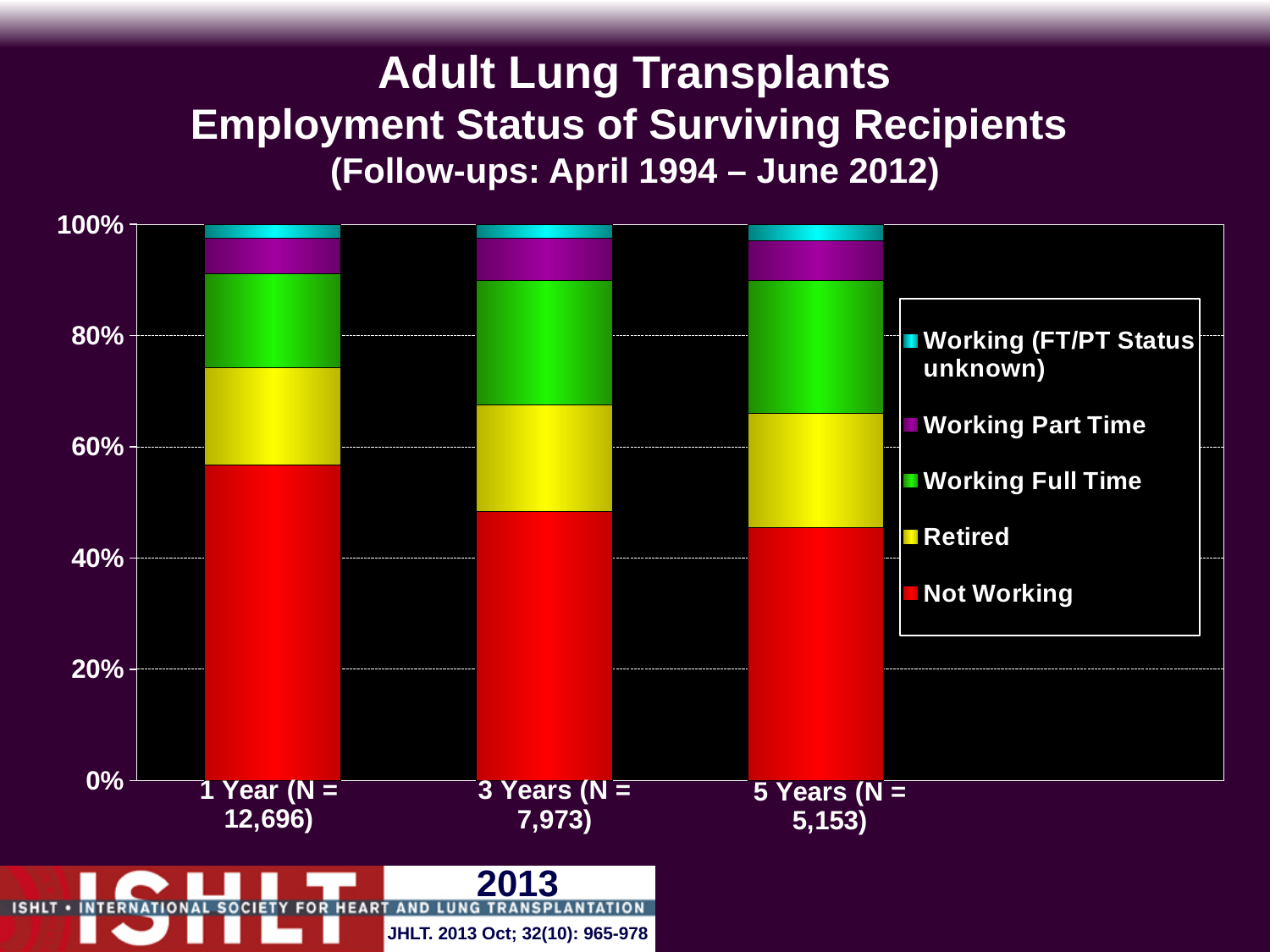
Does the Not Working share rise or fall from 1 Year to 5 Years? Fall Which follow-up time has the larger Not Working share, 1 Year or 5 Years? 1 Year Is the Not Working segment for 1 Year greater or less than 40%? greater Which follow-up time has the largest Not Working share? 1 Year (N = 12,696) Is the Not Working segment for 5 Years greater or less than 60%? less Is the Not Working segment for 3 Years greater or less than 60%? less Which colour represents Retired in the legend? Yellow How many series does the legend list? 5 How many follow-up time categories are shown on the x axis? 3 What is the N shown for the 3 Years follow-up category? 7,973 What kind of chart is shown on the slide? Stacked bar chart Does the Working Full Time share rise or fall from 1 Year to 5 Years? Rise